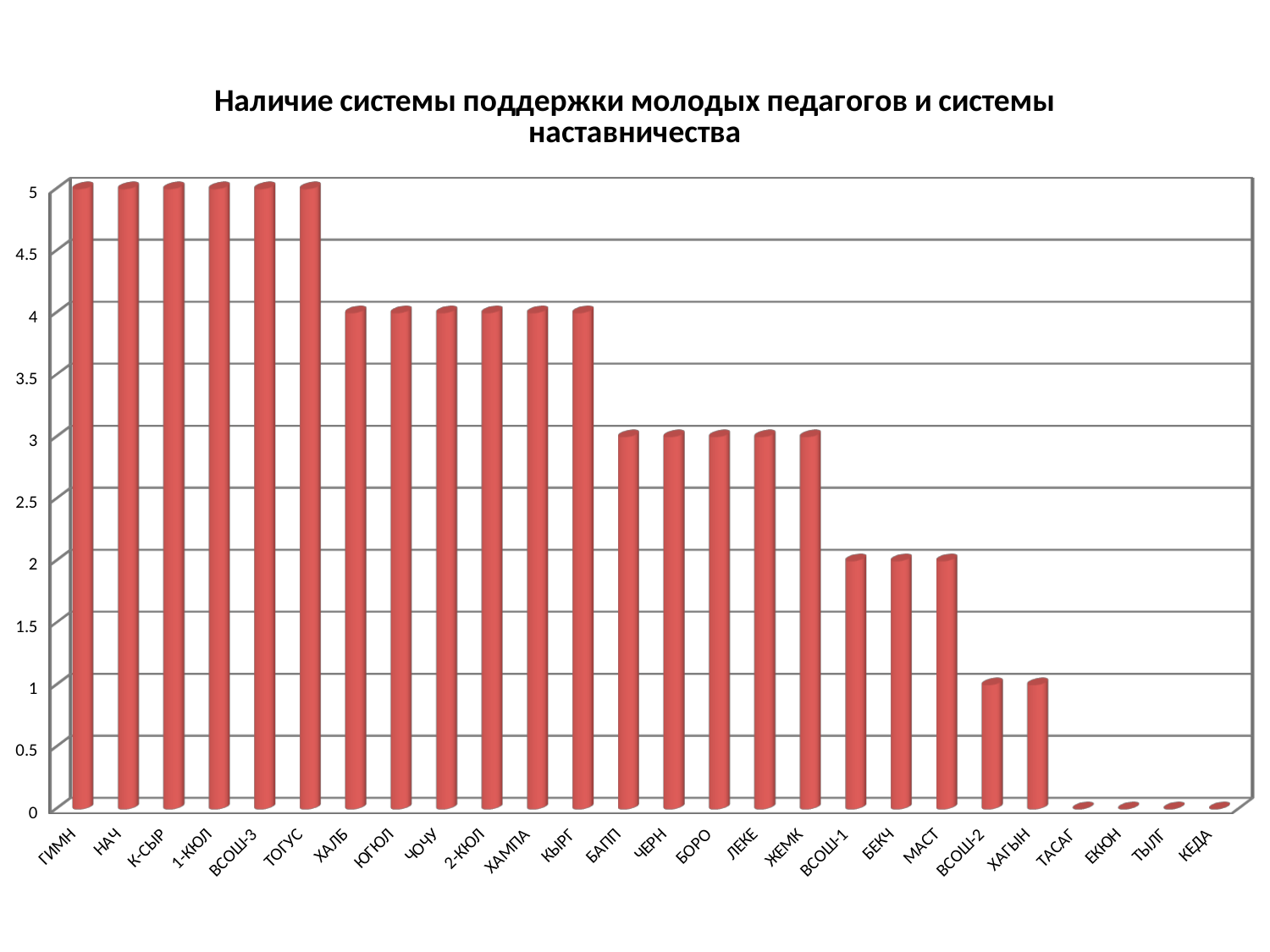
What is the value for КЕДА? 0 What is the value for МАСТ? 2 What kind of chart is shown on the slide? bar chart What is the difference between the value for ГИМН and the value for БАПП? 2 What is the value for ХАЛБ? 4 What is the value for БАПП? 3 Which is larger, the value for ТОГУС or the value for ЖЕМК? ТОГУС What is the title of the chart? Наличие системы поддержки молодых педагогов и системы наставничества Do the values rise or fall moving from left to right along the x axis? fall What is the value for ХАГЫН? 1 What is the value for ГИМН? 5 How many categories are shown on the x axis? 26